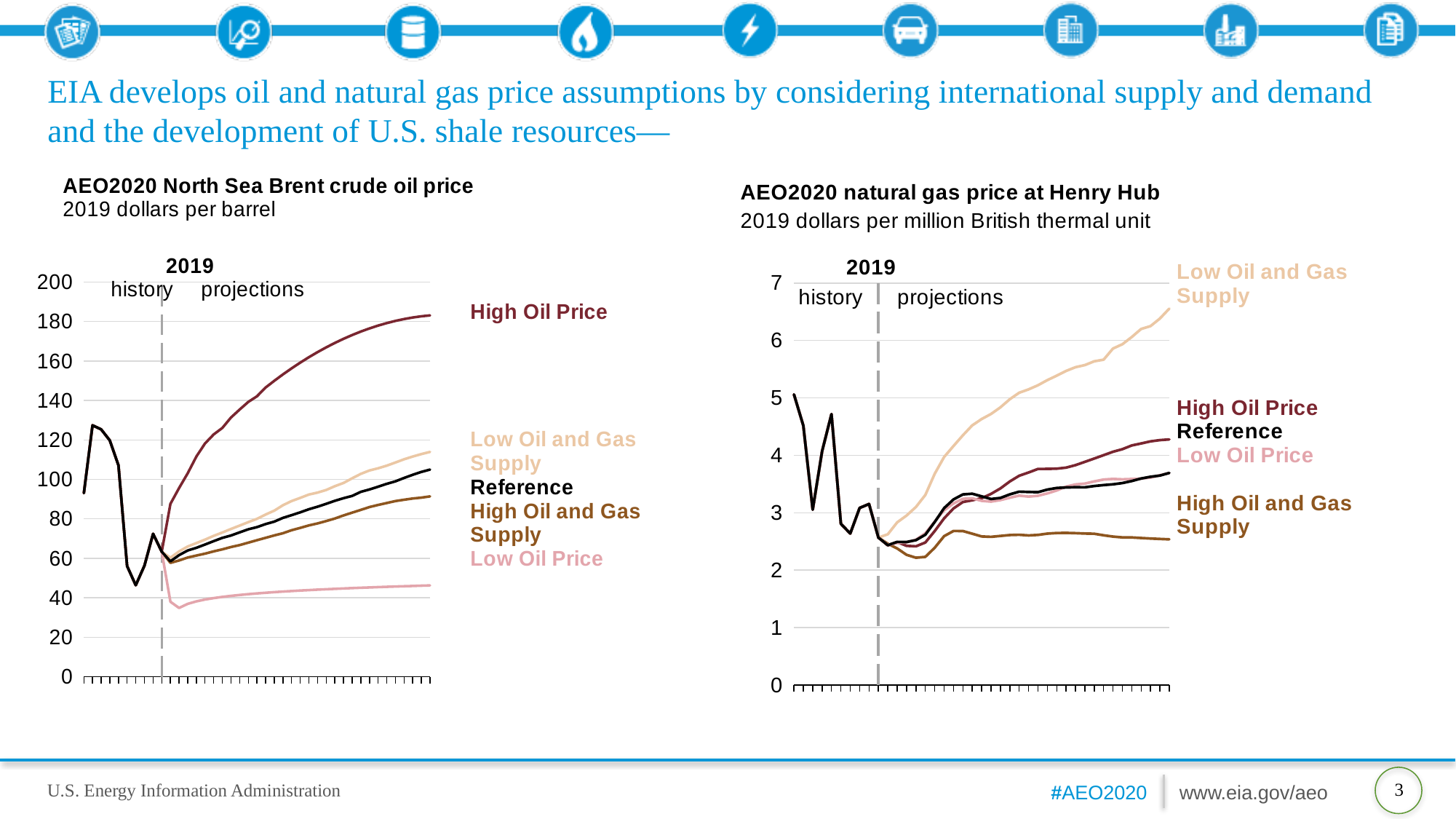
What kind of chart is the AEO2020 North Sea Brent crude oil price chart? line chart On the AEO2020 North Sea Brent crude oil price chart, does the High Oil Price line rise or fall over the projection period? rise On the AEO2020 North Sea Brent crude oil price chart, is the Low Oil Price value at the end of the projections greater or less than 60? less On the AEO2020 natural gas price at Henry Hub chart, is the High Oil and Gas Supply value at the end of the projections greater or less than 3? less On the AEO2020 North Sea Brent crude oil price chart, which scenario has the highest price at the end of the projection period? High Oil Price On the AEO2020 natural gas price at Henry Hub chart, which scenario has the lowest price at the end of the projection period? High Oil and Gas Supply On the AEO2020 North Sea Brent crude oil price chart, which scenario has the lowest price at the end of the projection period? Low Oil Price On the AEO2020 natural gas price at Henry Hub chart, which scenario has the highest price at the end of the projection period? Low Oil and Gas Supply What unit is used on the AEO2020 natural gas price at Henry Hub chart? 2019 dollars per million British thermal unit How many scenario series are labelled on the AEO2020 natural gas price at Henry Hub chart? 5 On the AEO2020 natural gas price at Henry Hub chart, is the Low Oil and Gas Supply value at the end of the projections greater or less than 6? greater